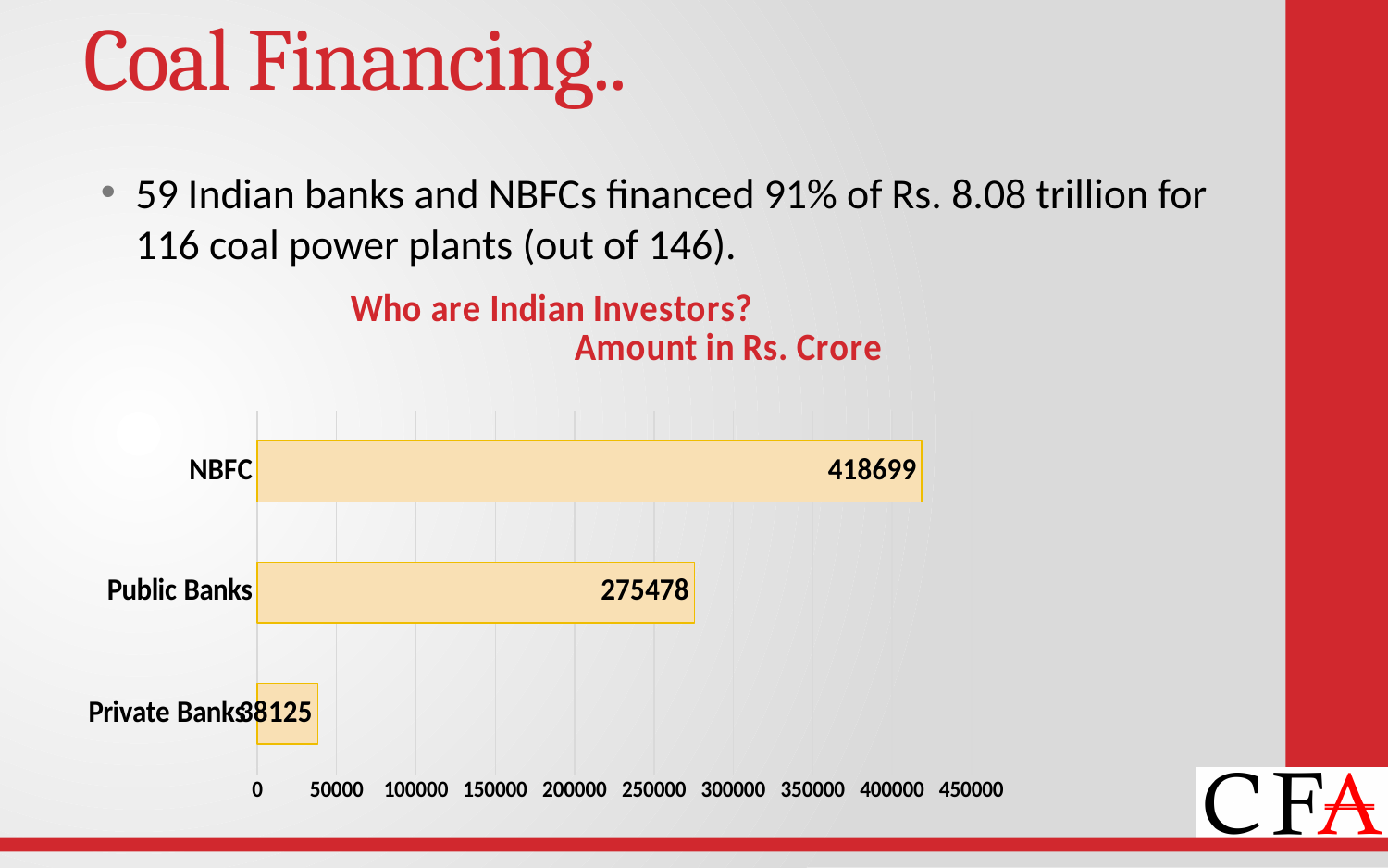
What is the amount for Private Banks? 38125 What is the difference between the amounts for Public Banks and Private Banks? 237353 What is the amount for NBFC? 418699 Is the value for Private Banks greater or less than 50000? less What is the amount for Public Banks? 275478 Which category has the highest amount? NBFC What unit does the chart title say the amounts are in? Rs. Crore What kind of chart is shown on the slide? bar chart What is the difference between the amounts for NBFC and Public Banks? 143221 Which category has the lowest amount? Private Banks Which is larger, the amount for Public Banks or for Private Banks? Public Banks How many categories are shown in the chart? 3